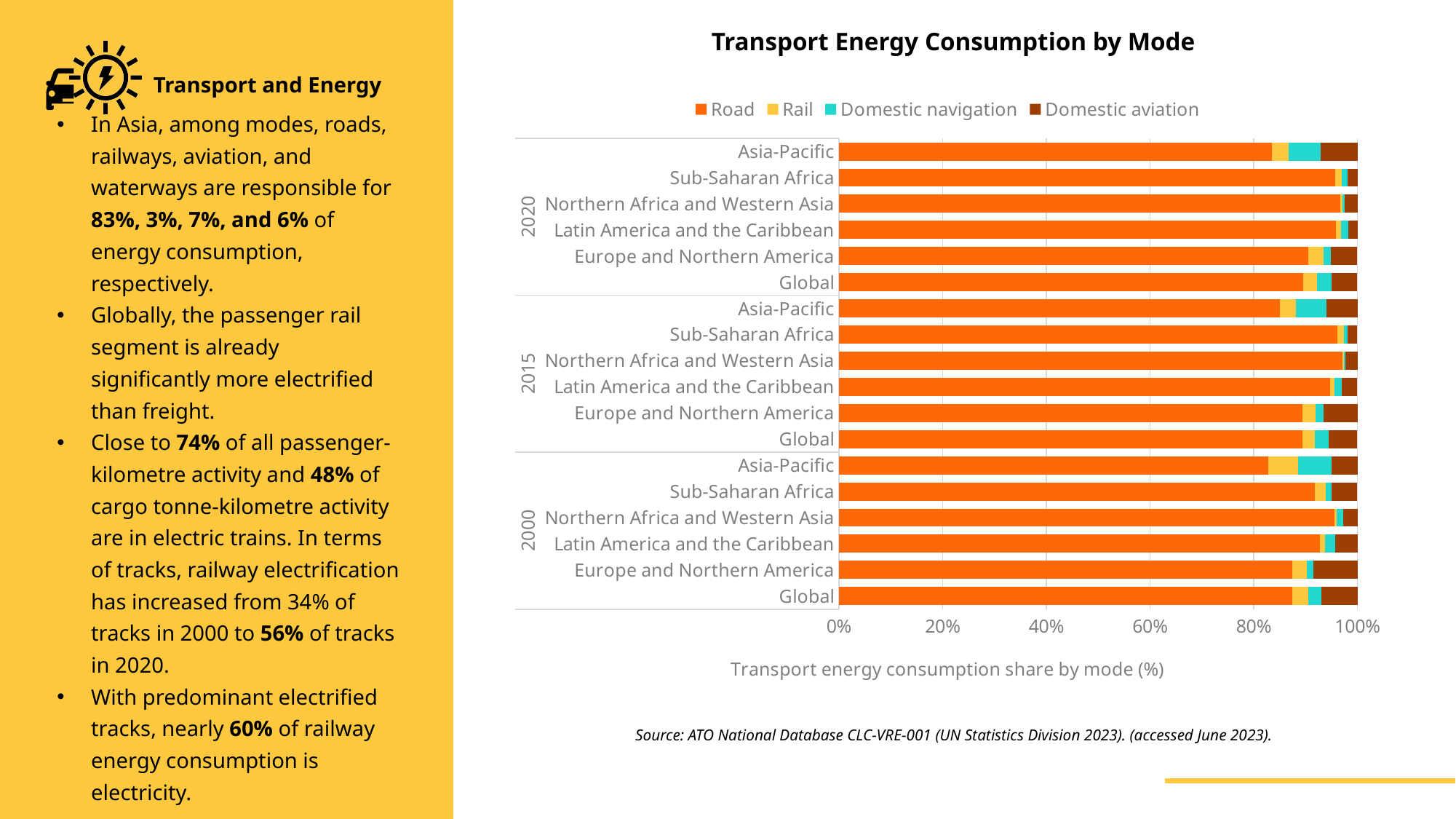
How many bars are plotted in the chart in total? 18 How many series does the chart legend list? 4 What is the title of the chart? Transport Energy Consumption by Mode Is the Road share for Global in 2000 greater or less than 80%? greater Is the Road share for Asia-Pacific in 2020 greater or less than 80%? greater In 2020, which has the larger Road share: Asia-Pacific or Sub-Saharan Africa? Sub-Saharan Africa How many years are shown in the chart? 3 How many regions are plotted for each year in the chart? 6 Which transport modes are listed in the chart legend? Road, Rail, Domestic navigation, Domestic aviation In 2020, which has the larger Domestic navigation share: Asia-Pacific or Northern Africa and Western Asia? Asia-Pacific In 2020, which region has the smallest Road share? Asia-Pacific What kind of chart is shown on the slide? Stacked bar chart